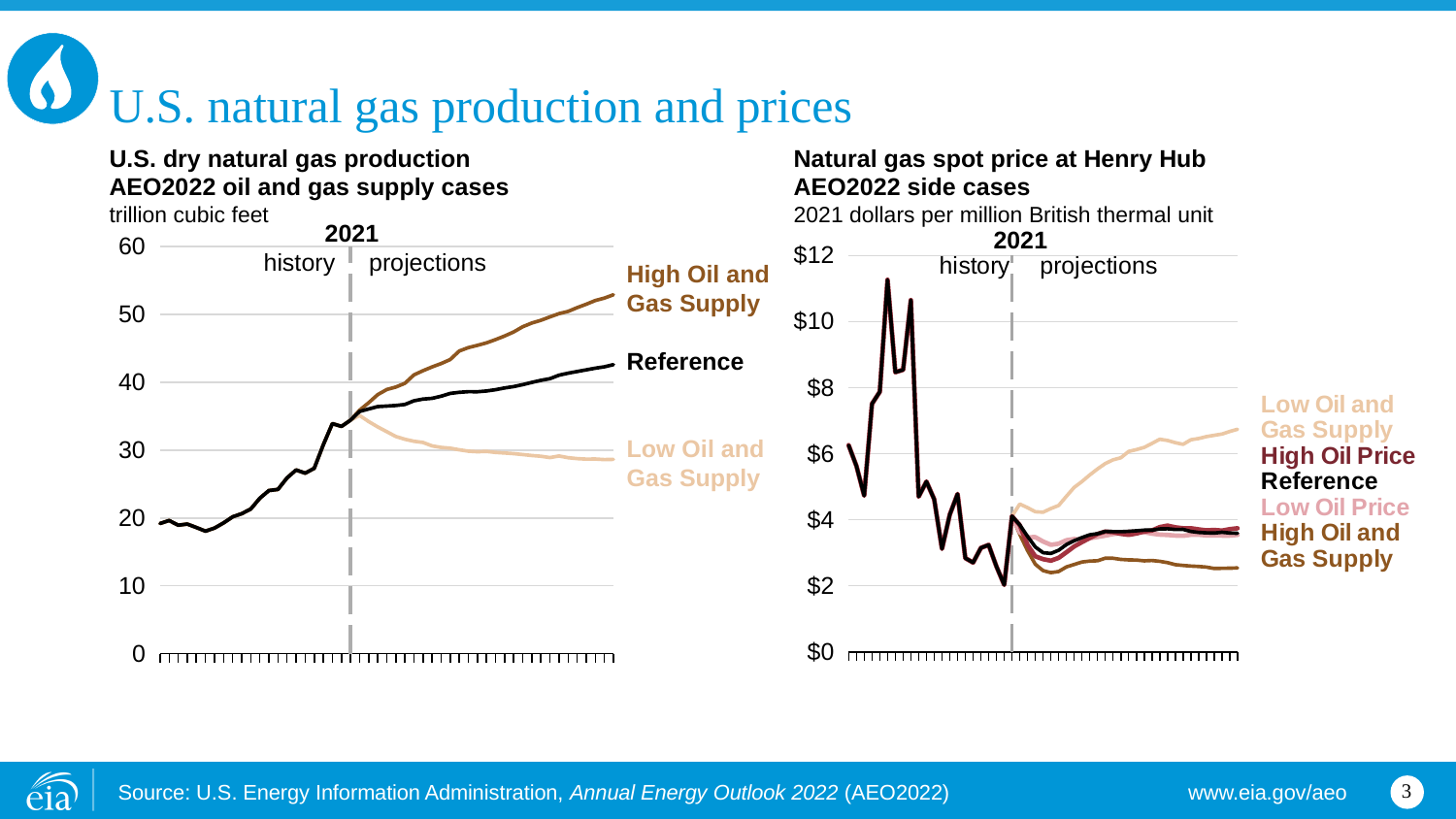
On the U.S. dry natural gas production chart, does the Low Oil and Gas Supply series rise or fall over the projection period? fall On the U.S. dry natural gas production chart, is the value for Low Oil and Gas Supply at the end of the projection period greater or less than 30? less On the Natural gas spot price at Henry Hub chart, is the highest historical price greater or less than $10? greater On the Natural gas spot price at Henry Hub chart, is the value for High Oil and Gas Supply at the end of the projection period greater or less than $4? less What kind of chart is the U.S. dry natural gas production chart on the left? line chart What unit is used on the U.S. dry natural gas production chart? trillion cubic feet How many series are shown on the Natural gas spot price at Henry Hub chart on the right? 5 How many series are shown on the U.S. dry natural gas production chart on the left? 3 On the Natural gas spot price at Henry Hub chart, which series is higher at the end of the projection period, Low Oil and Gas Supply or High Oil and Gas Supply? Low Oil and Gas Supply On the U.S. dry natural gas production chart, which series is higher at the end of the projection period, High Oil and Gas Supply or Reference? High Oil and Gas Supply